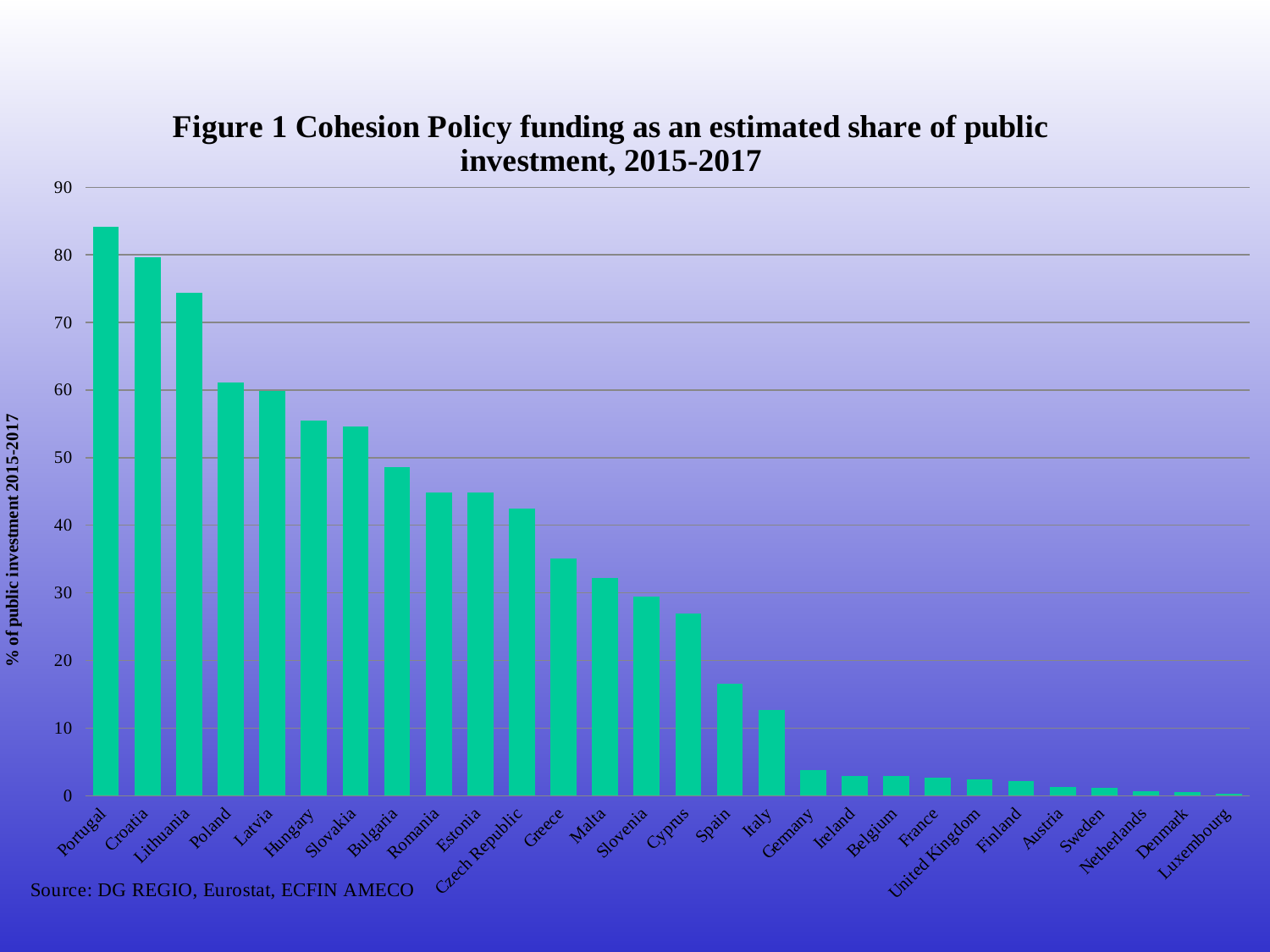
Is the value for Spain greater or less than 20? less How many countries are shown on the x axis? 28 Do the values rise or fall moving from left to right along the x axis? fall Which has a larger value, Croatia or Poland? Croatia Is the value for Lithuania greater or less than 70? greater Is the value for Greece greater or less than 30? greater Which country has the highest share of public investment from Cohesion Policy funding? Portugal What is the label on the vertical axis? % of public investment 2015-2017 What kind of chart is shown on the slide? bar chart Which country has the lowest share of public investment from Cohesion Policy funding? Luxembourg